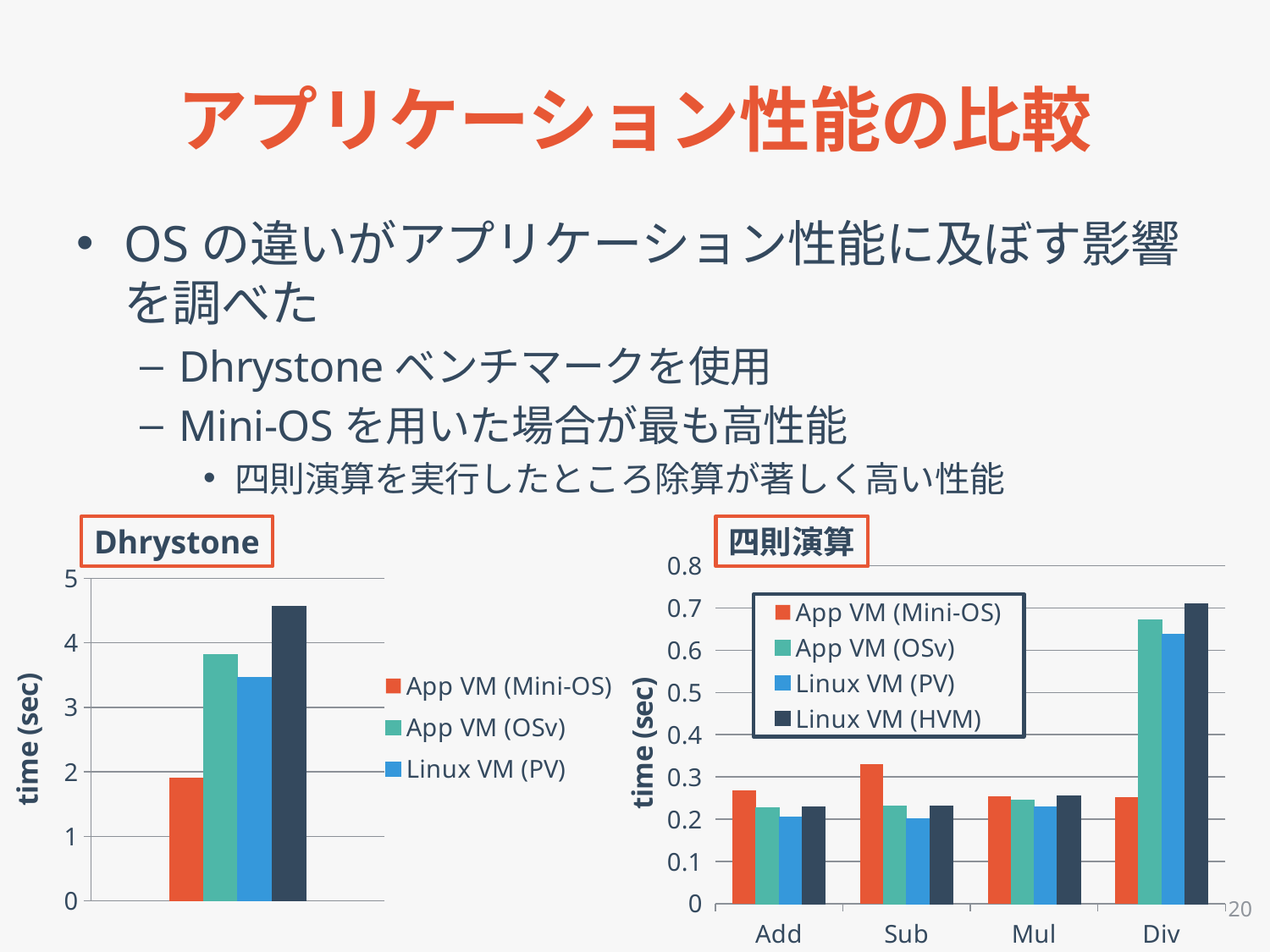
In the 四則演算 chart, how many series does the legend list? 4 In the Dhrystone chart, how many entries does the legend list? 3 In the 四則演算 chart, how many categories are shown on the x axis? 4 In the 四則演算 chart, is the value for App VM (Mini-OS) at Div greater or less than 0.3? less In the 四則演算 chart, is the value for App VM (OSv) at Div greater or less than 0.6? greater In the Dhrystone chart, which series has the lowest time? App VM (Mini-OS) In the 四則演算 chart, which series has the highest time for Div? Linux VM (HVM) In the Dhrystone chart, what kind of chart is shown? bar chart In the Dhrystone chart, which is larger, the value for App VM (OSv) or the value for Linux VM (PV)? App VM (OSv) In the Dhrystone chart, is the value for App VM (Mini-OS) greater or less than 2? less In the 四則演算 chart, which is larger, the value for App VM (Mini-OS) at Sub or the value for Linux VM (PV) at Sub? App VM (Mini-OS)